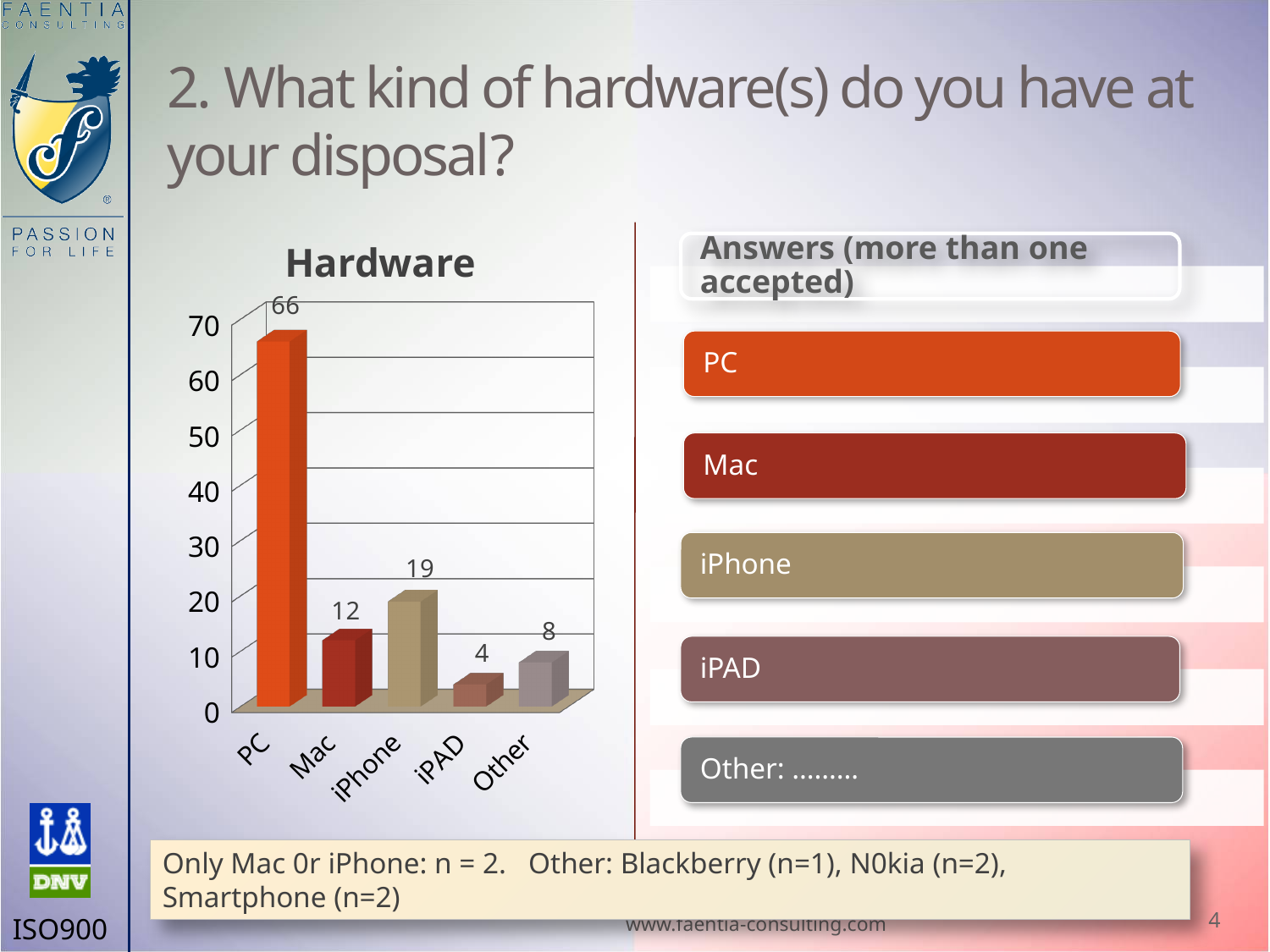
Which category has the highest value in the Hardware chart? PC What is the difference between the values for iPhone and Other in the Hardware chart? 11 Which category has the lowest value in the Hardware chart? iPAD What is the value for iPhone in the Hardware chart? 19 What is the value for PC in the Hardware chart? 66 How many categories are shown in the Hardware chart? 5 What kind of chart is the Hardware chart? bar chart What is the difference between the values for PC and Mac in the Hardware chart? 54 Is the value for iPhone in the Hardware chart greater or less than 10? greater What is the title of the chart on the slide? Hardware What is the value for iPAD in the Hardware chart? 4 Which is larger in the Hardware chart, the value for Mac or the value for Other? Mac